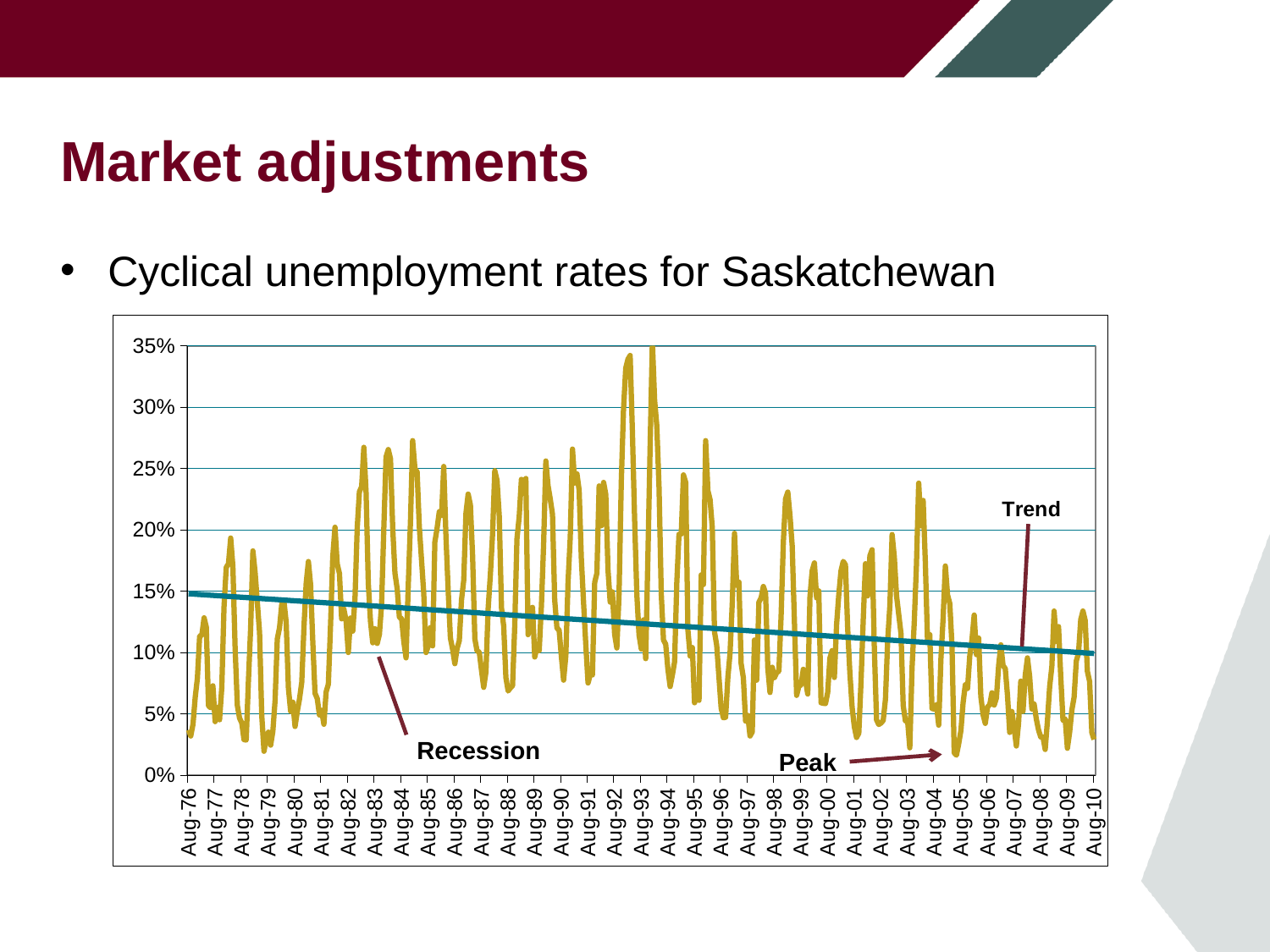
What is the first label on the x axis? Aug-76 Is the value of the gold line at Aug-76 greater or less than 10%? less Is the value of the trend line at Aug-10 greater or less than 15%? less Does the trend line rise or fall from Aug-76 to Aug-10? fall Is the highest peak of the gold unemployment line greater or less than 30%? greater How many year labels are shown along the x axis? 35 Around which year label does the gold line reach its highest peak? Aug-93 What is the highest value shown on the y axis? 35% What kind of chart is shown on the slide? line chart Which annotation label points to the straight teal line on the chart? Trend What is the last label on the x axis? Aug-10